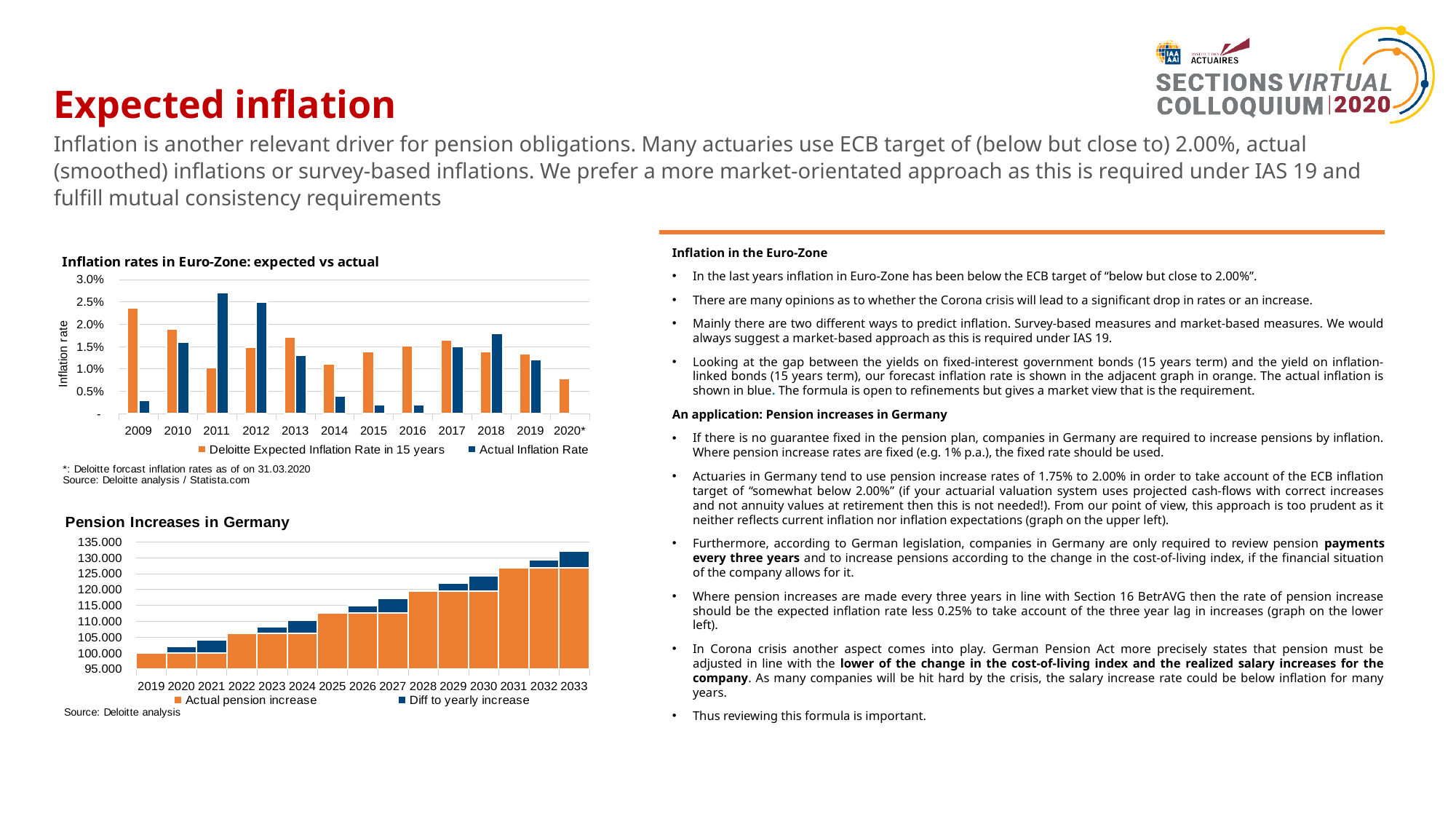
How many series does the legend of 'Inflation rates in Euro-Zone: expected vs actual' list? 2 In 'Inflation rates in Euro-Zone: expected vs actual', which is larger for 2013: the Deloitte Expected Inflation Rate in 15 years or the Actual Inflation Rate? Deloitte Expected Inflation Rate in 15 years What type of chart is 'Inflation rates in Euro-Zone: expected vs actual'? bar chart What type of chart is 'Pension Increases in Germany'? stacked bar chart In 'Inflation rates in Euro-Zone: expected vs actual', which year has the highest Deloitte Expected Inflation Rate in 15 years? 2009 In 'Inflation rates in Euro-Zone: expected vs actual', is the Actual Inflation Rate for 2014 greater or less than 0.5%? less In 'Inflation rates in Euro-Zone: expected vs actual', which year has the highest Actual Inflation Rate? 2011 In 'Inflation rates in Euro-Zone: expected vs actual', is the Deloitte Expected Inflation Rate in 15 years for 2009 greater or less than 2.0%? greater In 'Pension Increases in Germany', is the total of the stacked bar for 2033 greater or less than 130.000? greater How many years are shown on the x axis of 'Inflation rates in Euro-Zone: expected vs actual'? 12 How many years are shown on the x axis of 'Pension Increases in Germany'? 15 In 'Pension Increases in Germany', do the stacked bar totals rise or fall from 2019 to 2033? rise